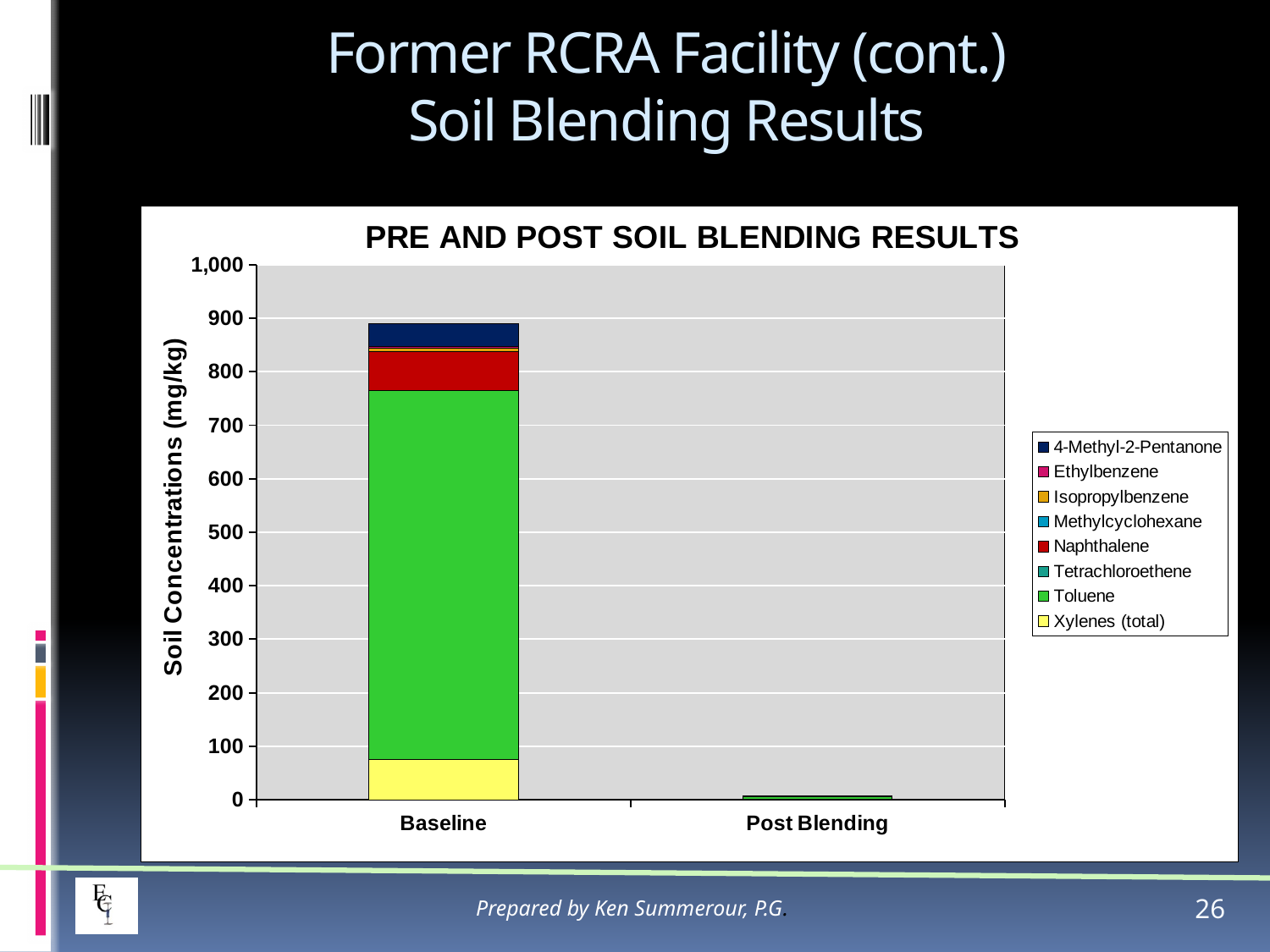
Which series makes up the largest segment of the Baseline bar? Toluene Do the total values rise or fall from Baseline to Post Blending? fall Which category has the higher total stacked bar, Baseline or Post Blending? Baseline Which category has the lowest total soil concentration? Post Blending What is the label of the y axis? Soil Concentrations (mg/kg) What is the title of the chart? PRE AND POST SOIL BLENDING RESULTS How many series does the chart's legend list? 8 How many categories are shown on the x axis of the chart? 2 Is the total value for Post Blending greater or less than 100? less Is the Toluene segment of the Baseline bar greater or less than 500? greater What kind of chart is shown on the slide? Stacked bar chart Is the total value for Baseline greater or less than 800? greater